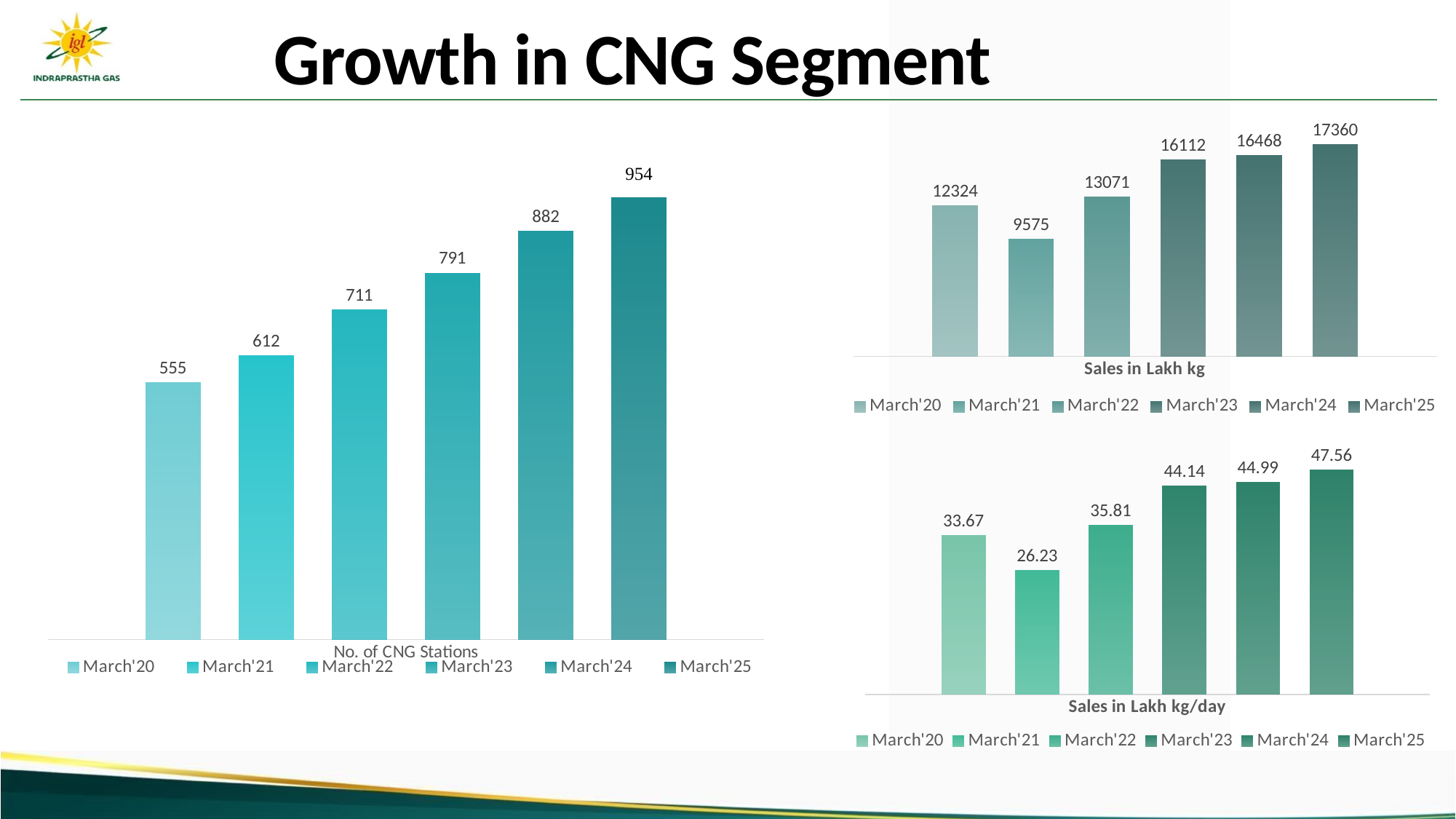
How many entries does the legend of the 'Sales in Lakh kg' chart list? 6 What kind of chart is the 'Sales in Lakh kg/day' chart? Bar chart In the 'Sales in Lakh kg' chart, which year has the lowest value? March'21 In the 'Sales in Lakh kg' chart, what is the difference between March'25 and March'24? 892 In the 'Sales in Lakh kg/day' chart, what is the value for March'23? 44.14 In the 'Sales in Lakh kg/day' chart, which is larger, March'20 or March'22? March'22 In the 'No. of CNG Stations' chart, what is the value for March'20? 555 In the 'No. of CNG Stations' chart, what is the difference between March'25 and March'24? 72 In the 'No. of CNG Stations' chart, what is the value for March'25? 954 In the 'Sales in Lakh kg' chart, which year has the highest value? March'25 In the 'Sales in Lakh kg' chart, what is the value for March'21? 9575 In the 'No. of CNG Stations' chart, how many bars are plotted? 6